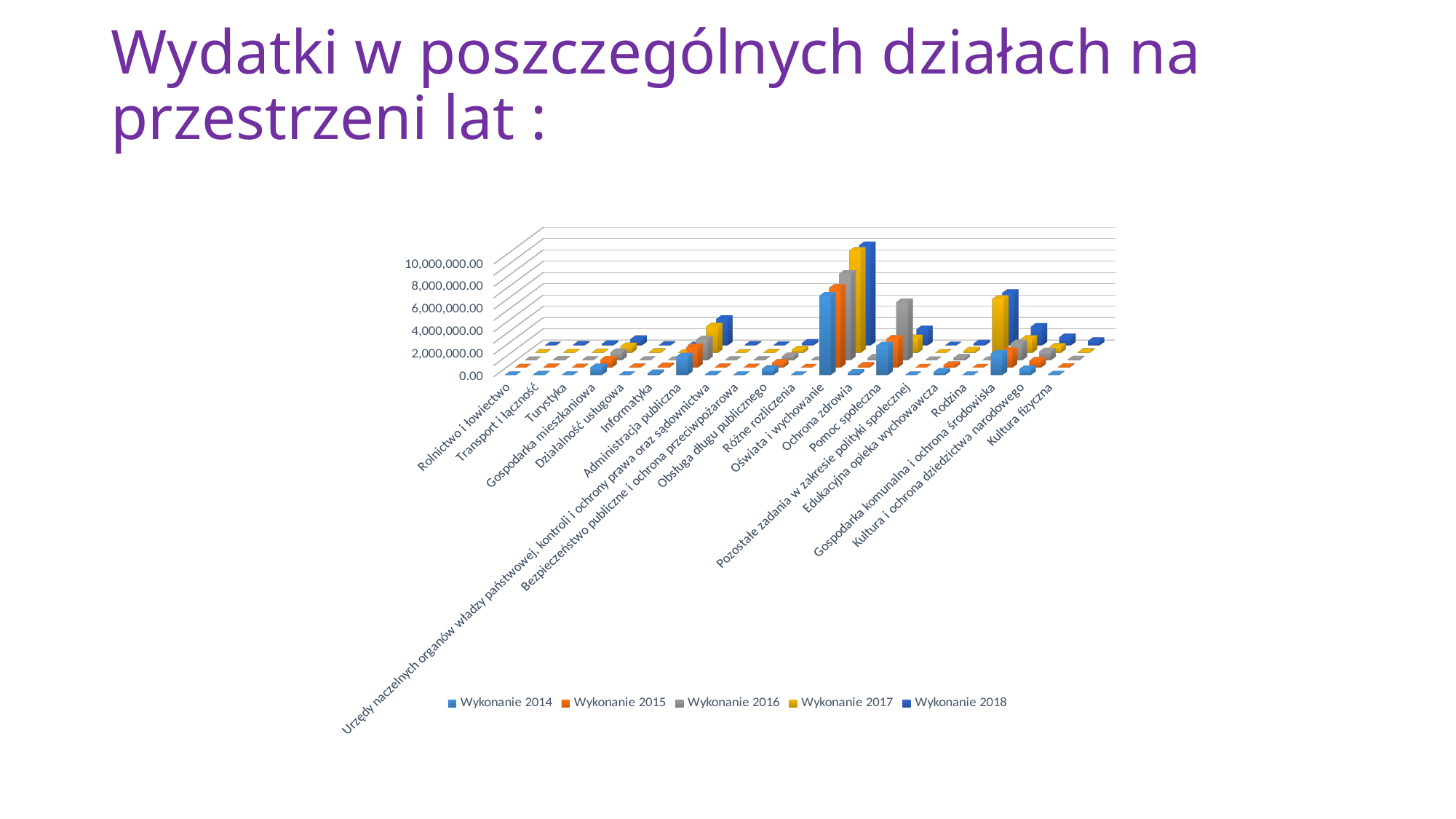
Which series is shown in yellow in the legend? Wykonanie 2017 Is the value for Rodzina in Wykonanie 2014 greater or less than 2,000,000.00? less What is the title of the slide containing the chart? Wydatki w poszczególnych działach na przestrzeni lat : Is the value for Oświata i wychowanie in Wykonanie 2014 greater or less than 4,000,000.00? greater Which category has the highest value for Wykonanie 2018? Oświata i wychowanie What kind of chart is shown on the slide? bar chart How many series does the legend list? 5 Is the value for Gospodarka komunalna i ochrona środowiska in Wykonanie 2017 greater or less than 4,000,000.00? less Which is larger for Rodzina: Wykonanie 2014 or Wykonanie 2017? Wykonanie 2017 Which is larger for Wykonanie 2014: Oświata i wychowanie or Turystyka? Oświata i wychowanie How many categories are shown on the x axis of the chart? 20 Which category has the highest value for Wykonanie 2014? Oświata i wychowanie